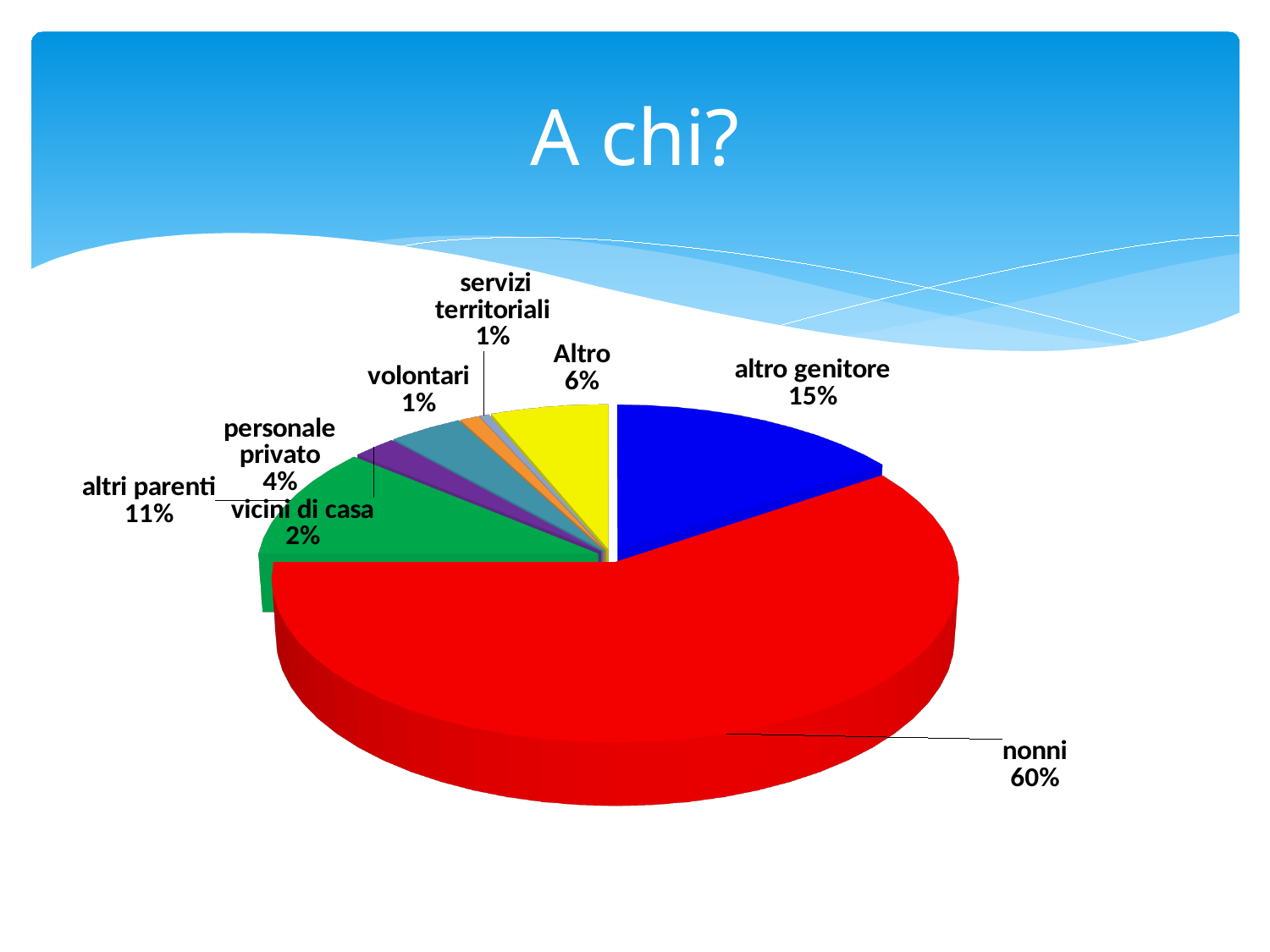
What is the title of the slide containing the chart? A chi? How many categories are shown in the pie chart? 8 Which category has the smallest share, "vicini di casa" or "volontari"? volontari What type of chart is shown on the slide? pie chart What percentage is shown for "personale privato"? 4% What percentage of the pie is labelled "nonni"? 60% Which is larger, "Altro" or "personale privato"? Altro Which category has the largest slice of the pie? nonni What is the value shown for "altri parenti"? 11% What is the difference in percentage points between "nonni" and "altro genitore"? 45 What colour is the "nonni" slice? red What share does "altro genitore" have in the pie chart? 15%